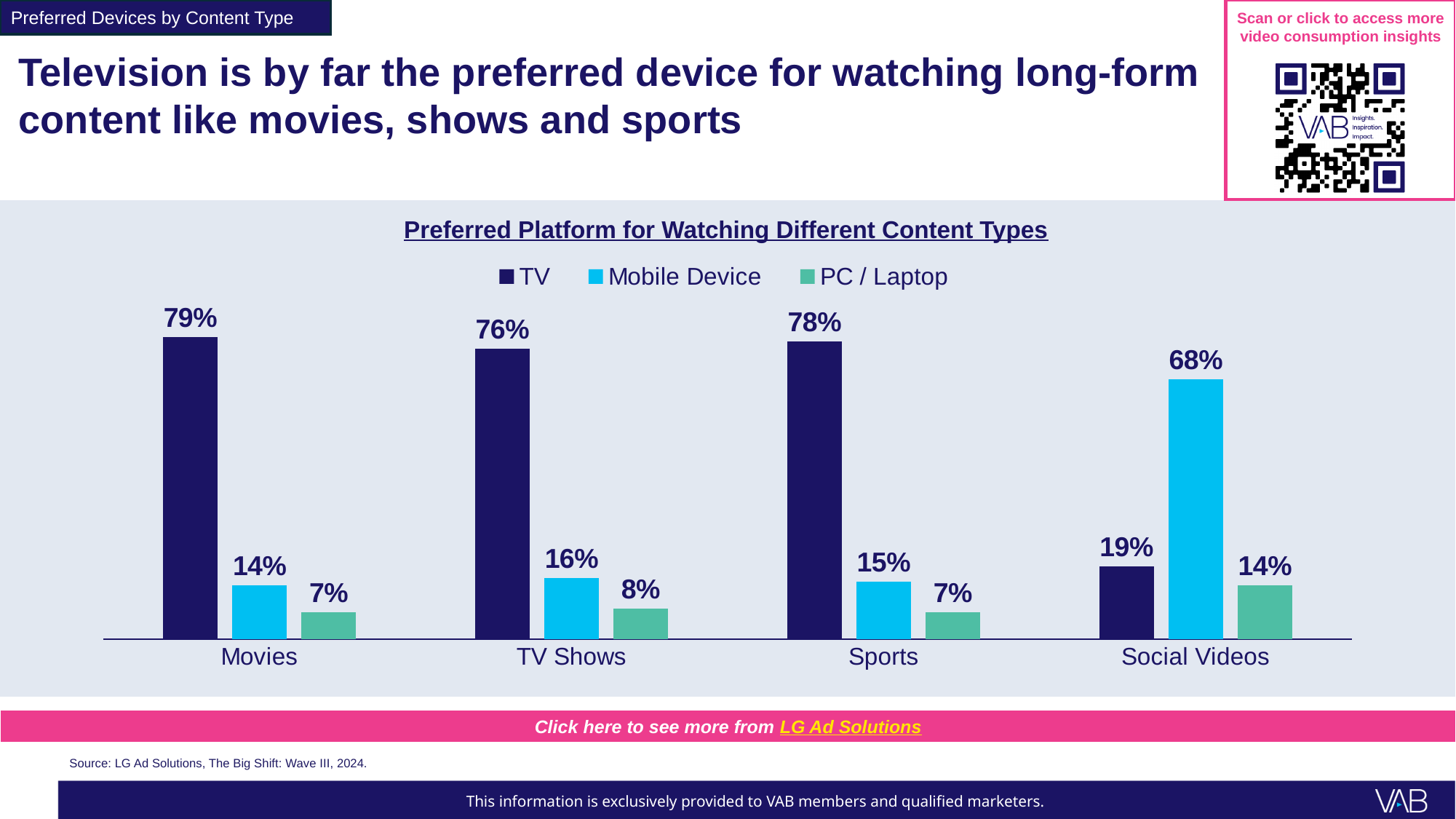
Which content type has the highest TV value? Movies What is the title of the chart? Preferred Platform for Watching Different Content Types How many content type categories are shown on the x axis? 4 What is the difference between the TV value and the Mobile Device value for Sports? 63% Which series is shown in dark navy bars? TV For Social Videos, which is larger: the Mobile Device value or the TV value? Mobile Device How many series does the legend list? 3 What is the PC / Laptop value for TV Shows? 8% What is the TV value for Movies? 79% Which content type has the lowest TV value? Social Videos What kind of chart is shown on the slide? Bar chart What is the Mobile Device value for Social Videos? 68%